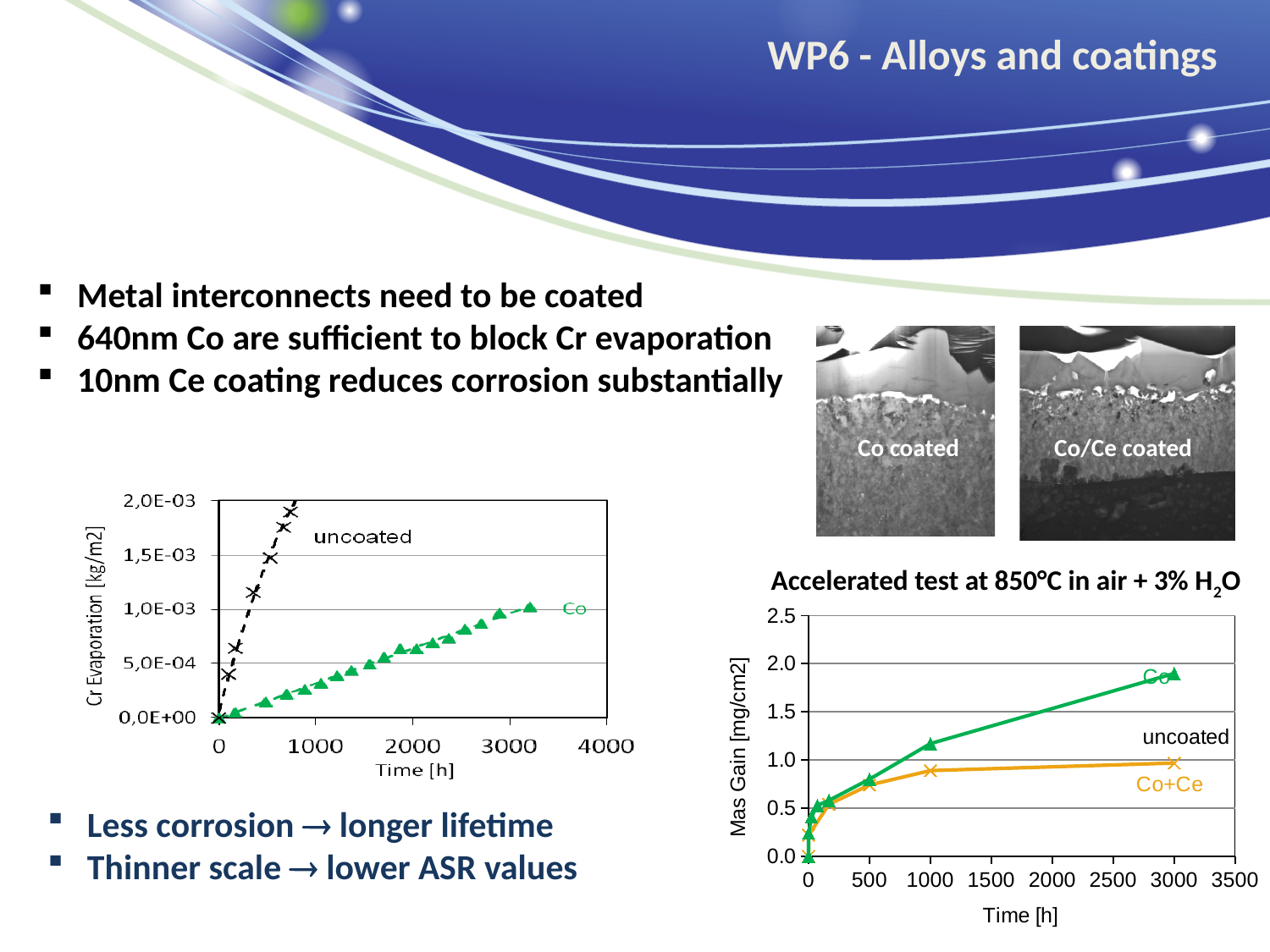
In the 'Accelerated test at 850°C in air + 3% H2O' chart, is the mass gain for Co at 1000 h greater or less than 1.0? greater In the Cr Evaporation chart on the left, does the Cr evaporation for Co rise or fall as time increases? rise What is the title of the chart on the right of the slide? Accelerated test at 850°C in air + 3% H2O What is the y-axis label of the Cr Evaporation chart on the left? Cr Evaporation [kg/m2] In the 'Accelerated test at 850°C in air + 3% H2O' chart, does the mass gain for Co rise or fall as time increases? rise In the Cr Evaporation chart on the left, which series reaches the higher Cr evaporation value, uncoated or Co? uncoated What kind of chart is the 'Accelerated test at 850°C in air + 3% H2O' chart on the right? line chart In the Cr Evaporation chart on the left, is the Cr evaporation for Co at 3000 h greater or less than 5,0E-04? greater In the 'Accelerated test at 850°C in air + 3% H2O' chart, is the mass gain for Co at 3000 h greater or less than 1.5? greater In the 'Accelerated test at 850°C in air + 3% H2O' chart, which series shows the higher mass gain at 3000 h, Co or Co+Ce? Co